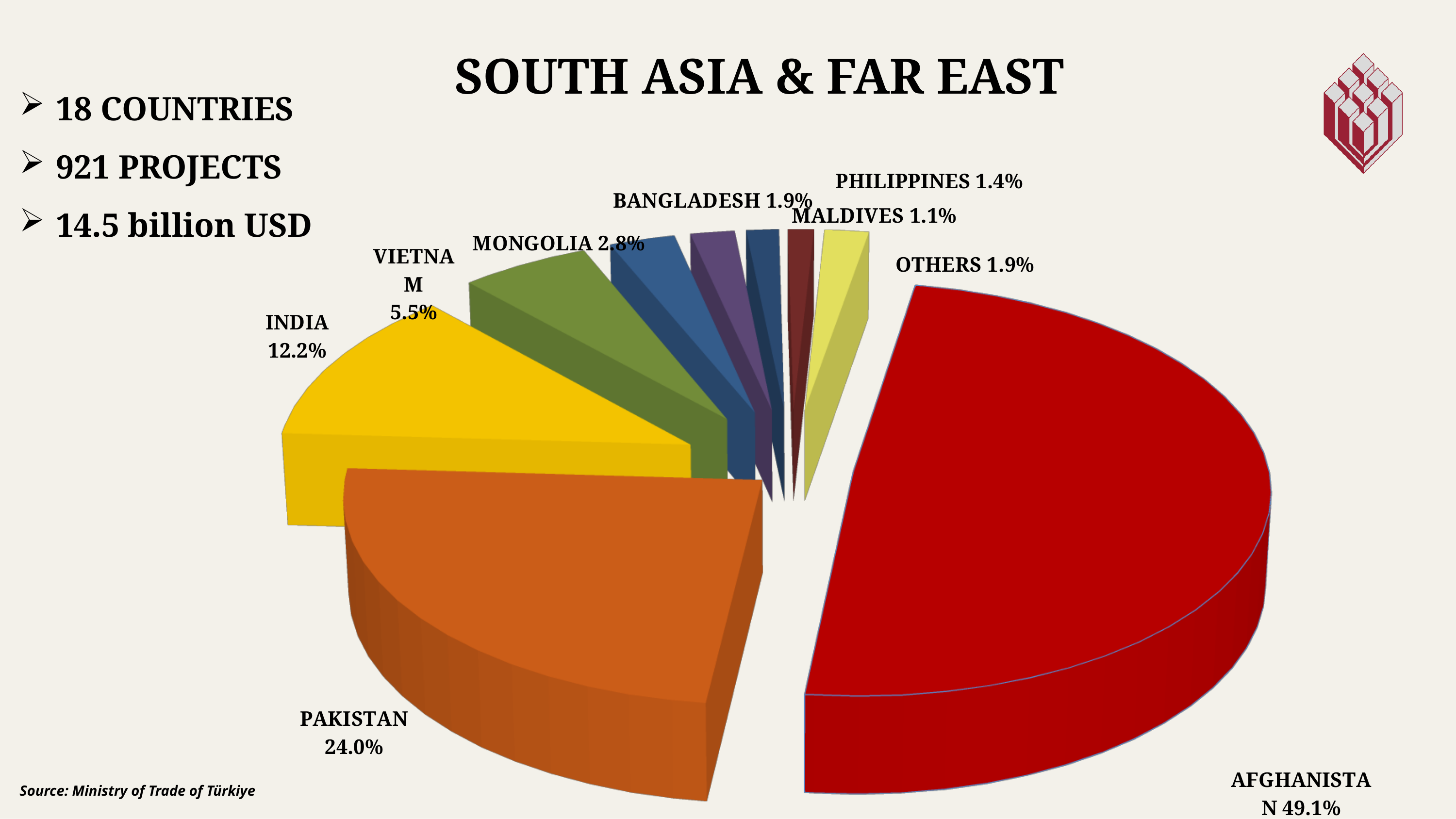
What colour is the Pakistan slice? orange Which slice has the smallest share of the pie? Maldives What is the value shown for Pakistan? 24.0% How many slices does the pie chart have? 9 What kind of chart is shown on the slide? pie chart What share of the pie does Afghanistan hold? 49.1% Which country has the largest slice of the pie? Afghanistan What is the value shown for India? 12.2% Which is larger, the share for Vietnam or the share for Mongolia? Vietnam What is the difference in percentage points between Pakistan and India? 11.8 What is the value shown for Mongolia? 2.8% What is the title of the chart? SOUTH ASIA & FAR EAST